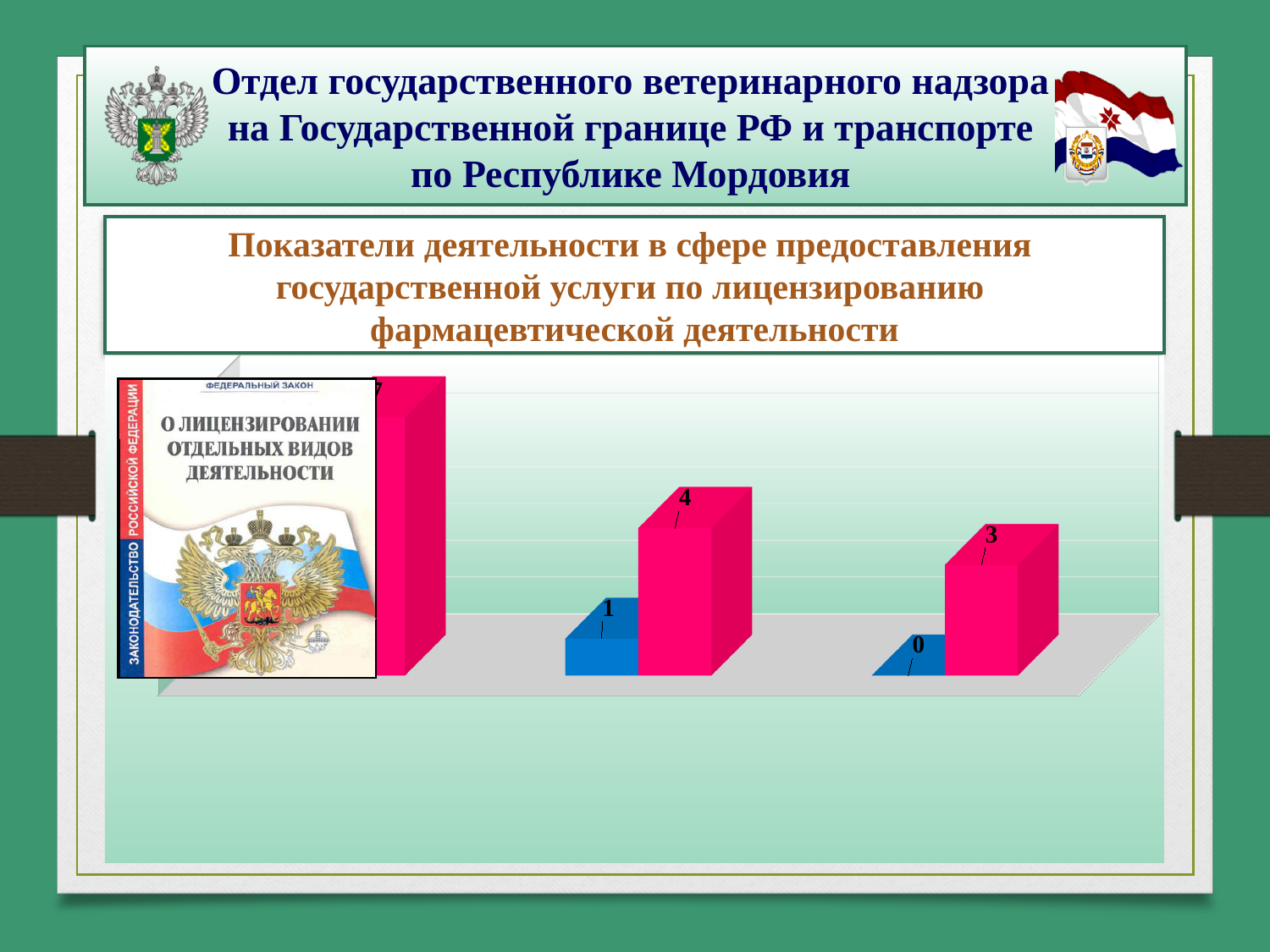
What is the value of the pink bar in the middle group? 4 What is the value of the blue bar in the rightmost group? 0 Which group has the tallest pink bar? the leftmost group What two colours are used for the bars in the chart? pink and blue In the middle group, how much larger is the pink bar than the blue bar? 3 What is the difference between the pink bar in the middle group and the pink bar in the rightmost group? 1 Do the pink bars rise or fall from left to right? fall How many groups of bars are shown in the chart? 3 What kind of chart is shown on the slide? bar chart What is the value of the pink bar in the rightmost group? 3 Which is larger: the pink bar in the middle group or the pink bar in the rightmost group? the middle group What is the value of the blue bar in the middle group? 1